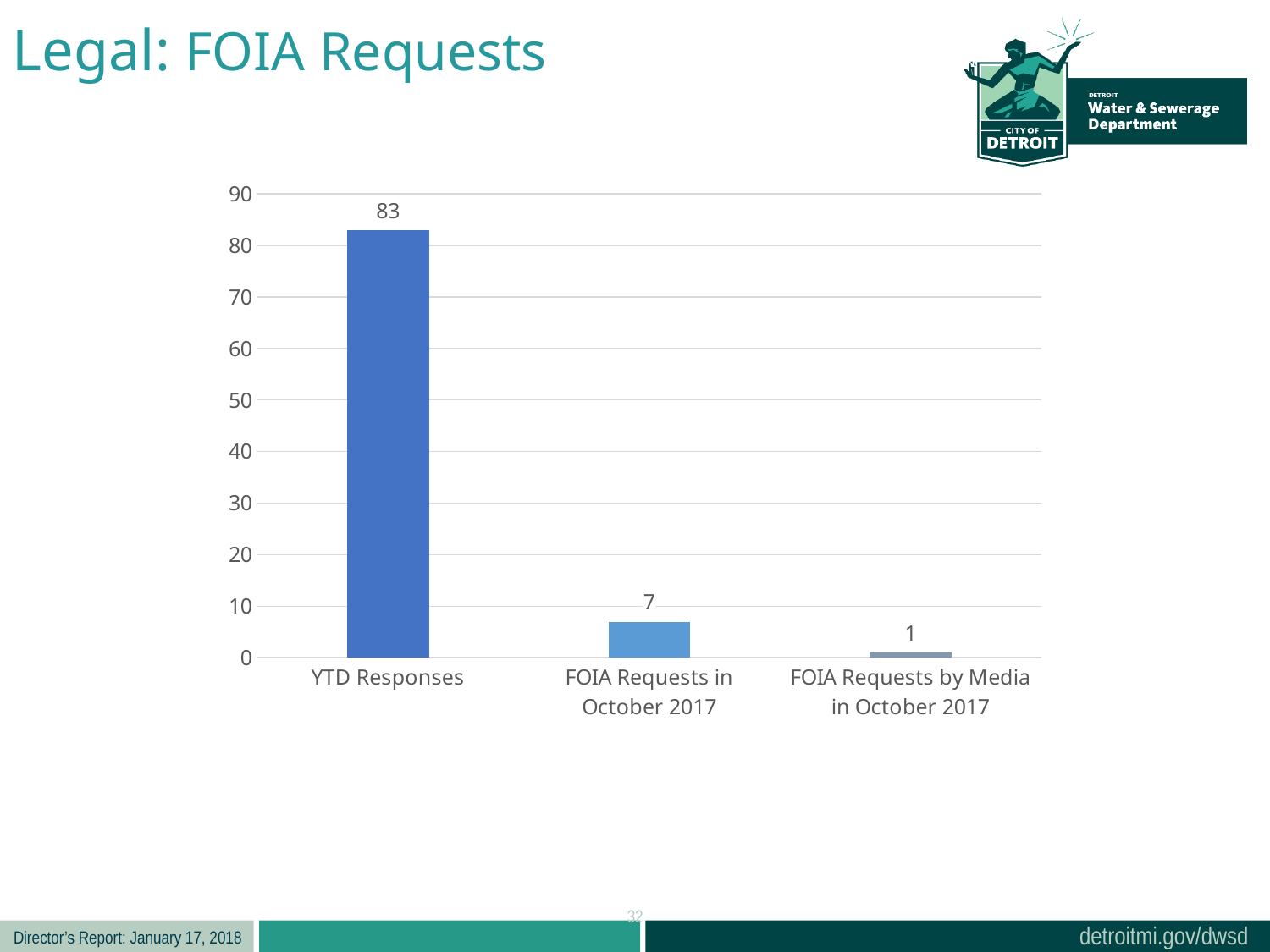
How many categories are shown on the chart? 3 What is the difference between YTD Responses and FOIA Requests in October 2017? 76 What is the value for FOIA Requests by Media in October 2017? 1 What kind of chart is shown on the slide? bar chart Which category has the highest value? YTD Responses Is the value for YTD Responses greater or less than 80? greater What is the value for FOIA Requests in October 2017? 7 What is the difference between FOIA Requests in October 2017 and FOIA Requests by Media in October 2017? 6 Which category has the lowest value? FOIA Requests by Media in October 2017 What is the value for YTD Responses? 83 Which is larger: FOIA Requests in October 2017 or FOIA Requests by Media in October 2017? FOIA Requests in October 2017 Do the values rise or fall from left to right across the categories? fall